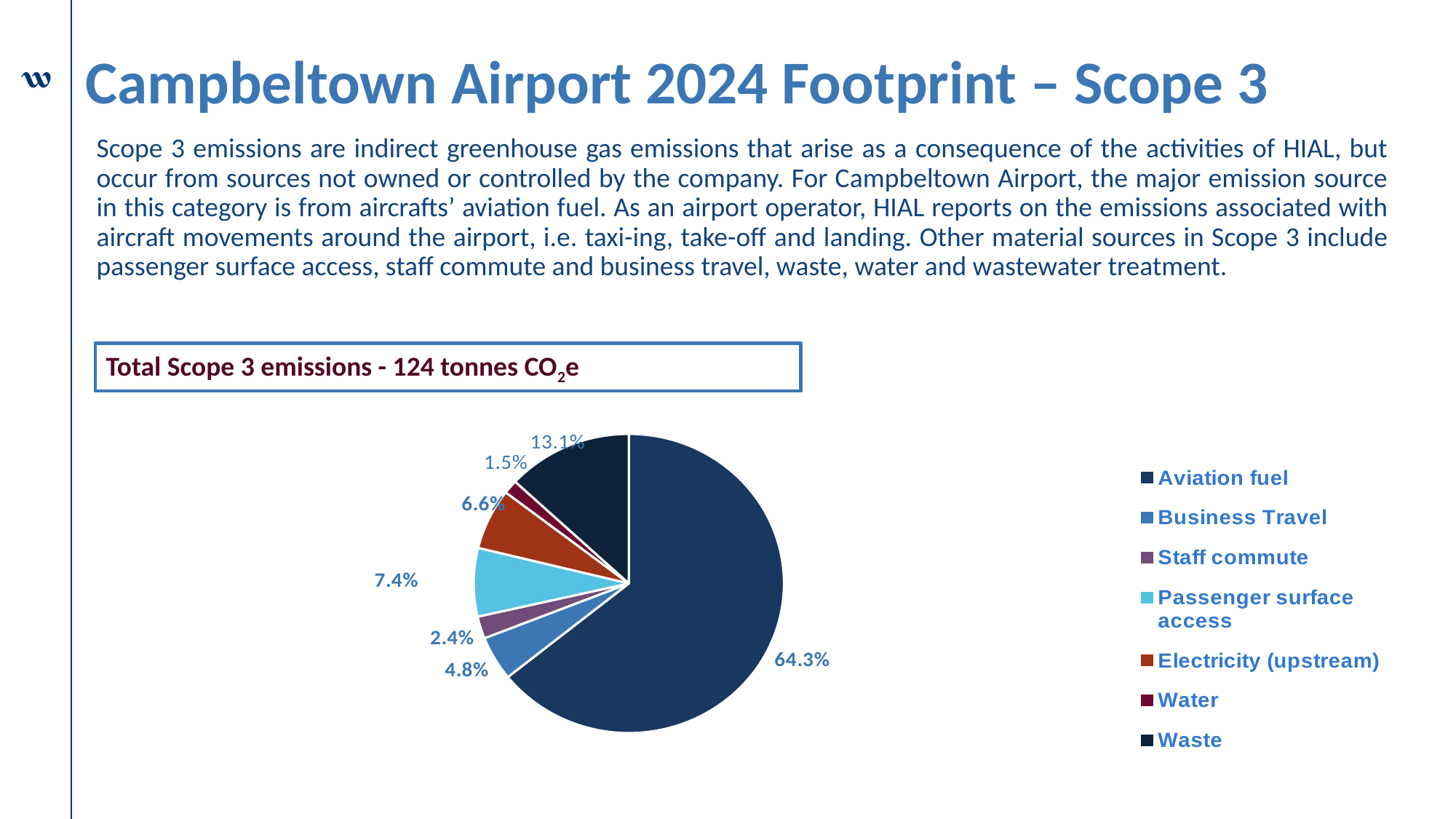
What share of Scope 3 emissions comes from Waste? 13.1% What share of Scope 3 emissions comes from Aviation fuel? 64.3% What share of Scope 3 emissions comes from Passenger surface access? 7.4% Which category has the smallest share of Scope 3 emissions? Water Which has a larger share, Staff commute or Business Travel? Business Travel What is the difference in percentage points between the Waste share and the Business Travel share? 8.3 How many categories does the legend list? 7 Which category has the largest share of Scope 3 emissions? Aviation fuel What kind of chart is shown on the slide? Pie chart What total Scope 3 emissions figure is stated above the chart? 124 tonnes CO2e